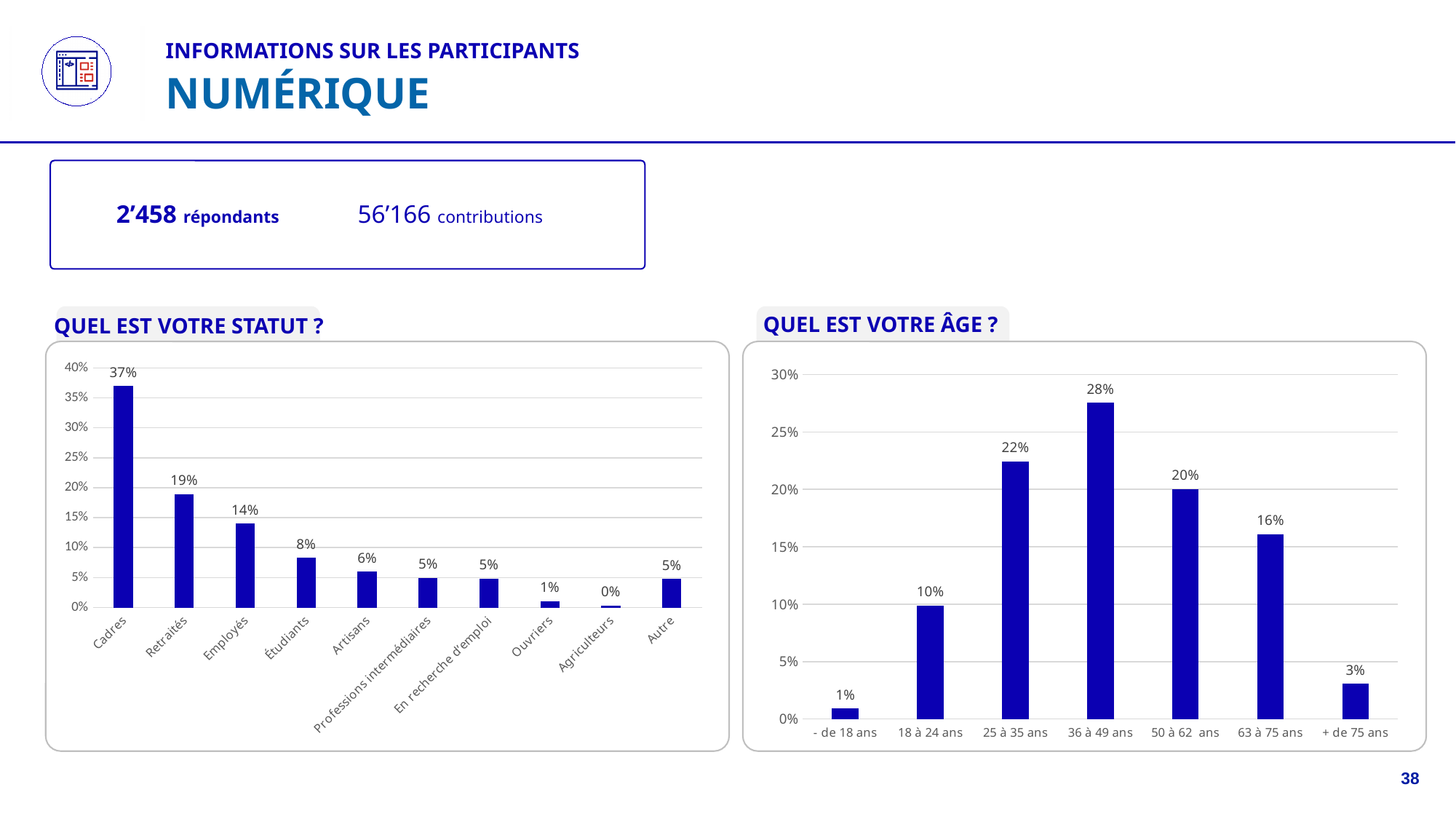
What kind of chart is the 'QUEL EST VOTRE ÂGE ?' chart? Bar chart In the 'QUEL EST VOTRE ÂGE ?' chart, which age group has the highest value? 36 à 49 ans In the 'QUEL EST VOTRE STATUT ?' chart, what is the value for Cadres? 37% In the 'QUEL EST VOTRE STATUT ?' chart, which is larger, Étudiants or Artisans? Étudiants In the 'QUEL EST VOTRE ÂGE ?' chart, what is the value for 36 à 49 ans? 28% In the 'QUEL EST VOTRE ÂGE ?' chart, how many age groups are shown? 7 In the 'QUEL EST VOTRE STATUT ?' chart, which category has the lowest value? Agriculteurs In the 'QUEL EST VOTRE STATUT ?' chart, how many categories are shown on the x axis? 10 In the 'QUEL EST VOTRE STATUT ?' chart, what is the difference between Cadres and Retraités? 18% In the 'QUEL EST VOTRE ÂGE ?' chart, what is the difference between 25 à 35 ans and 18 à 24 ans? 12% In the 'QUEL EST VOTRE STATUT ?' chart, what is the value for Employés? 14% In the 'QUEL EST VOTRE ÂGE ?' chart, what is the value for + de 75 ans? 3%